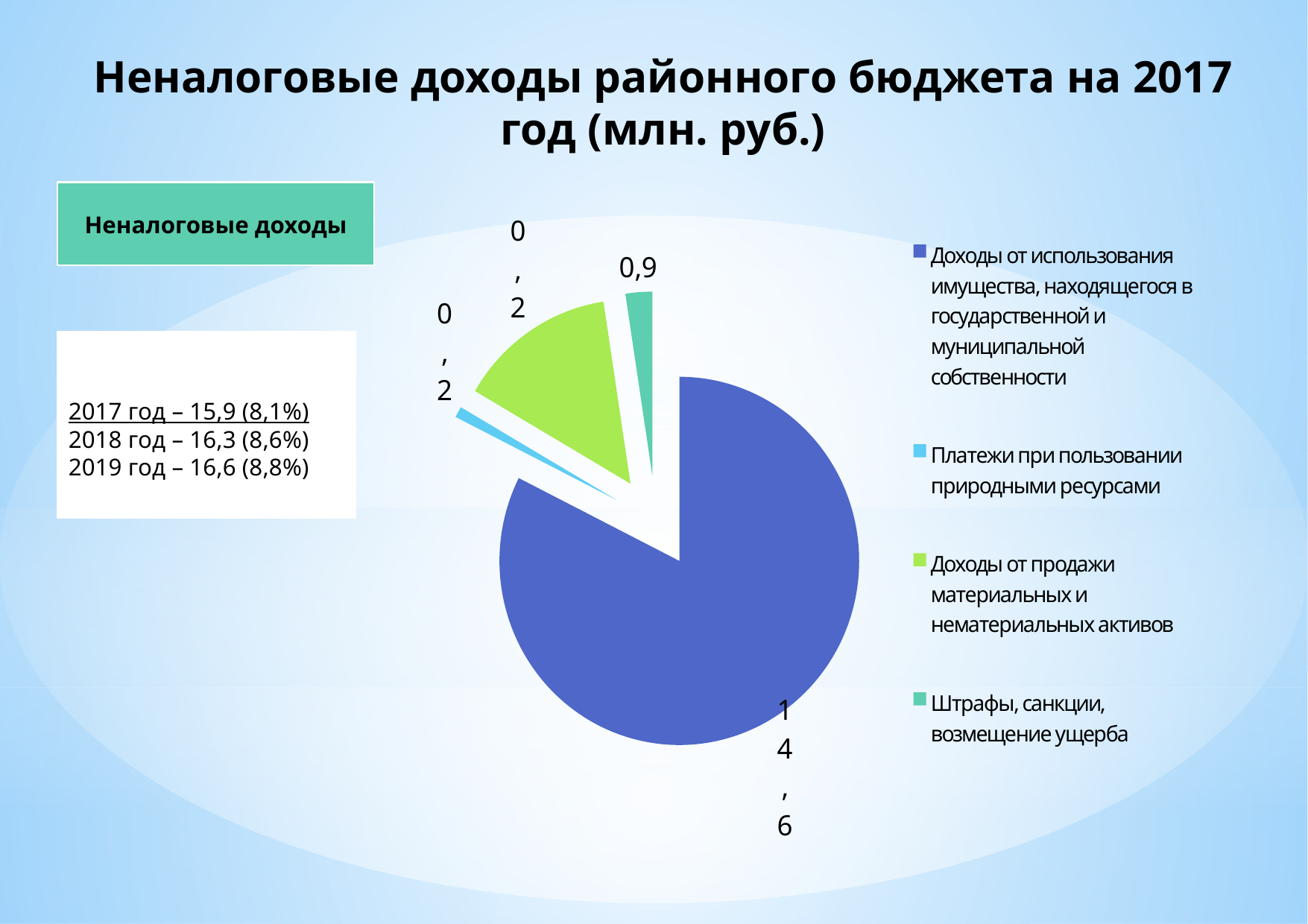
Which is larger: «Штрафы, санкции, возмещение ущерба» or «Платежи при пользовании природными ресурсами»? Штрафы, санкции, возмещение ущерба What is the title of the slide containing the chart? Неналоговые доходы районного бюджета на 2017 год (млн. руб.) What is the value for «Штрафы, санкции, возмещение ущерба»? 0,9 How many slices does the pie chart have? 4 What is the total of all the slice values shown on the pie chart? 15,9 What kind of chart is shown on the slide? pie chart How many entries does the legend list? 4 Which category has the largest slice of the pie? Доходы от использования имущества, находящегося в государственной и муниципальной собственности What is the value for «Доходы от использования имущества, находящегося в государственной и муниципальной собственности»? 14,6 What is the difference between the value for «Доходы от использования имущества» (14,6) and «Штрафы, санкции, возмещение ущерба» (0,9)? 13,7 Which legend entry is shown in green? Доходы от продажи материальных и нематериальных активов